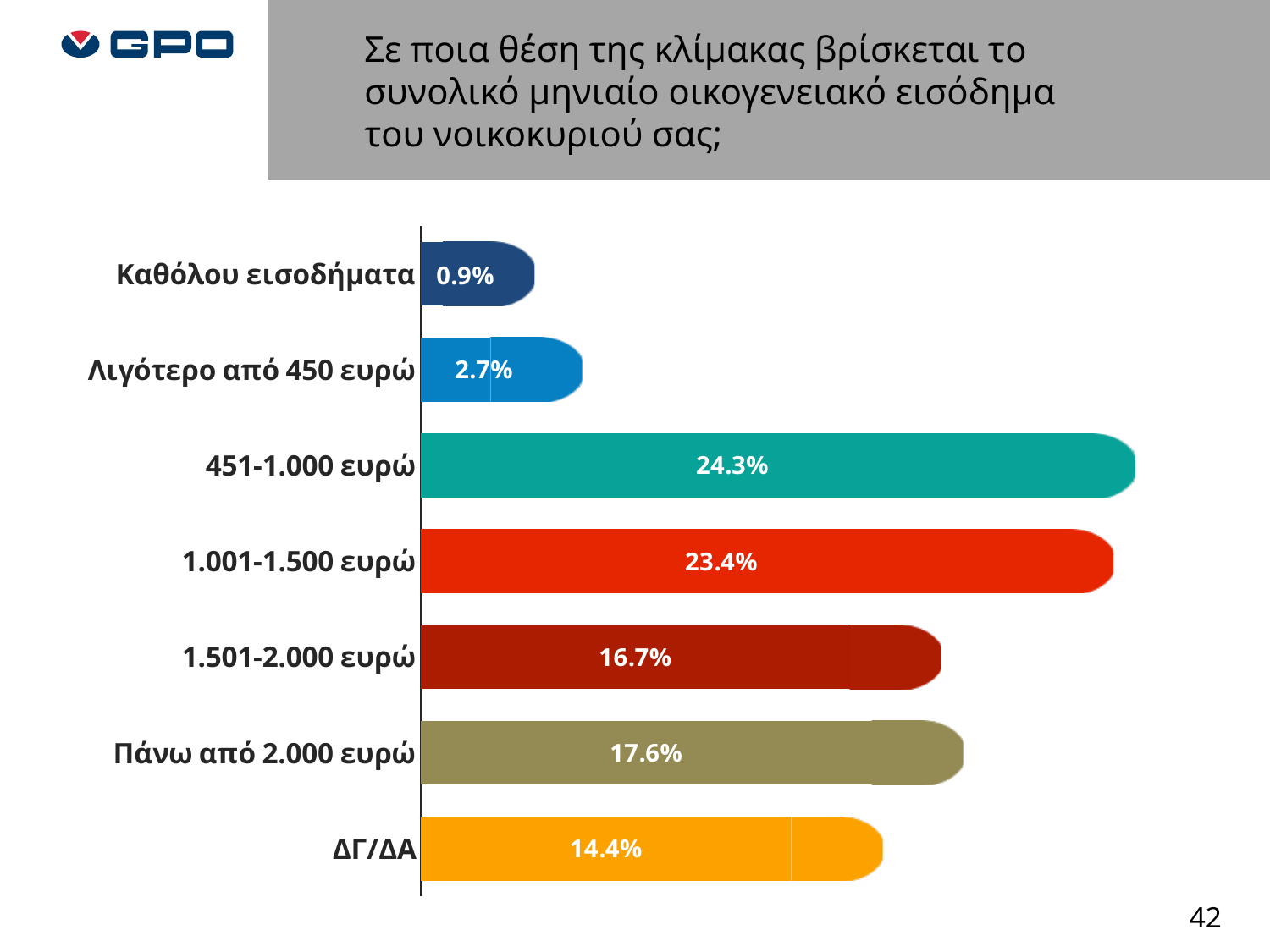
Which category has the lowest percentage? Καθόλου εισοδήματα Which income category has the highest percentage? 451-1.000 ευρώ What is the difference between the values for 'Πάνω από 2.000 ευρώ' and '1.501-2.000 ευρώ'? 0.9% What is the value shown for the category 'Καθόλου εισοδήματα'? 0.9% Which is larger: the value for '1.501-2.000 ευρώ' or the value for 'ΔΓ/ΔΑ'? 1.501-2.000 ευρώ What is the difference between the values for '451-1.000 ευρώ' and '1.001-1.500 ευρώ'? 0.9% What is the value for 'Πάνω από 2.000 ευρώ'? 17.6% What percentage of respondents reported a monthly household income of 451-1.000 ευρώ? 24.3% What percentage is shown for 'ΔΓ/ΔΑ'? 14.4% Which is larger: the value for 'Λιγότερο από 450 ευρώ' or the value for 'Καθόλου εισοδήματα'? Λιγότερο από 450 ευρώ What type of chart is shown on the slide? Bar chart How many income categories are shown in the chart? 7